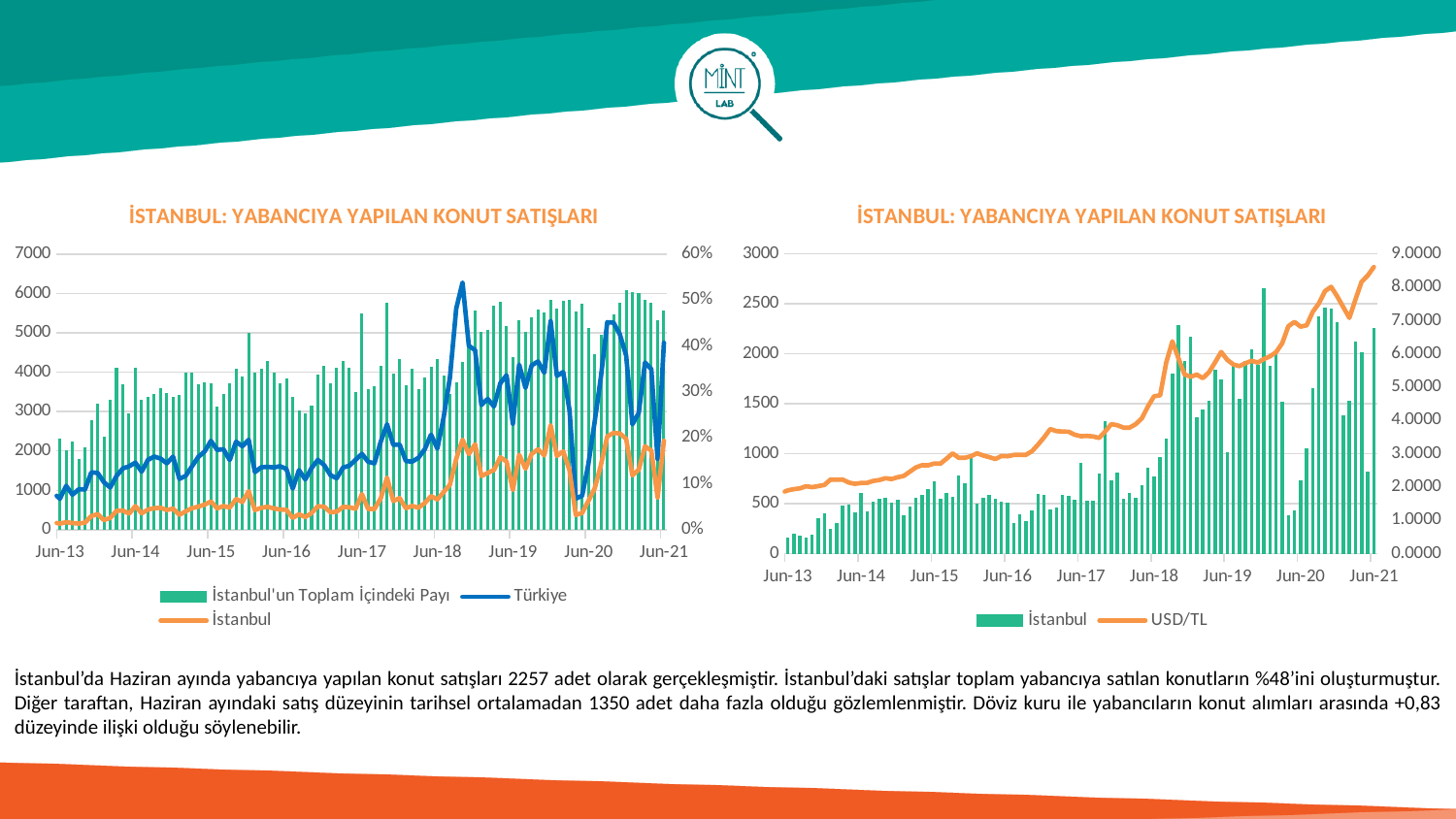
In the left chart, does the Türkiye line generally rise or fall from Jun-13 to Jun-21? Rise How many year labels are shown on the x axis of the right chart? 9 How many series does the legend of the left chart list? 3 In the left chart, is the Türkiye value at Jun-13 greater or less than 2000? less In the right chart, is the USD/TL value at Jun-21 greater or less than 8.0000? greater How many series does the legend of the right chart list? 2 In the right chart, is the USD/TL value at Jun-13 greater or less than 3.0000? less In the right chart, does the USD/TL line generally rise or fall from Jun-13 to Jun-21? Rise In the left chart, which series is shown as bars? İstanbul'un Toplam İçindeki Payı In the right chart, which series is drawn as a line? USD/TL What type of chart is the left chart on the slide? Combined bar and line chart